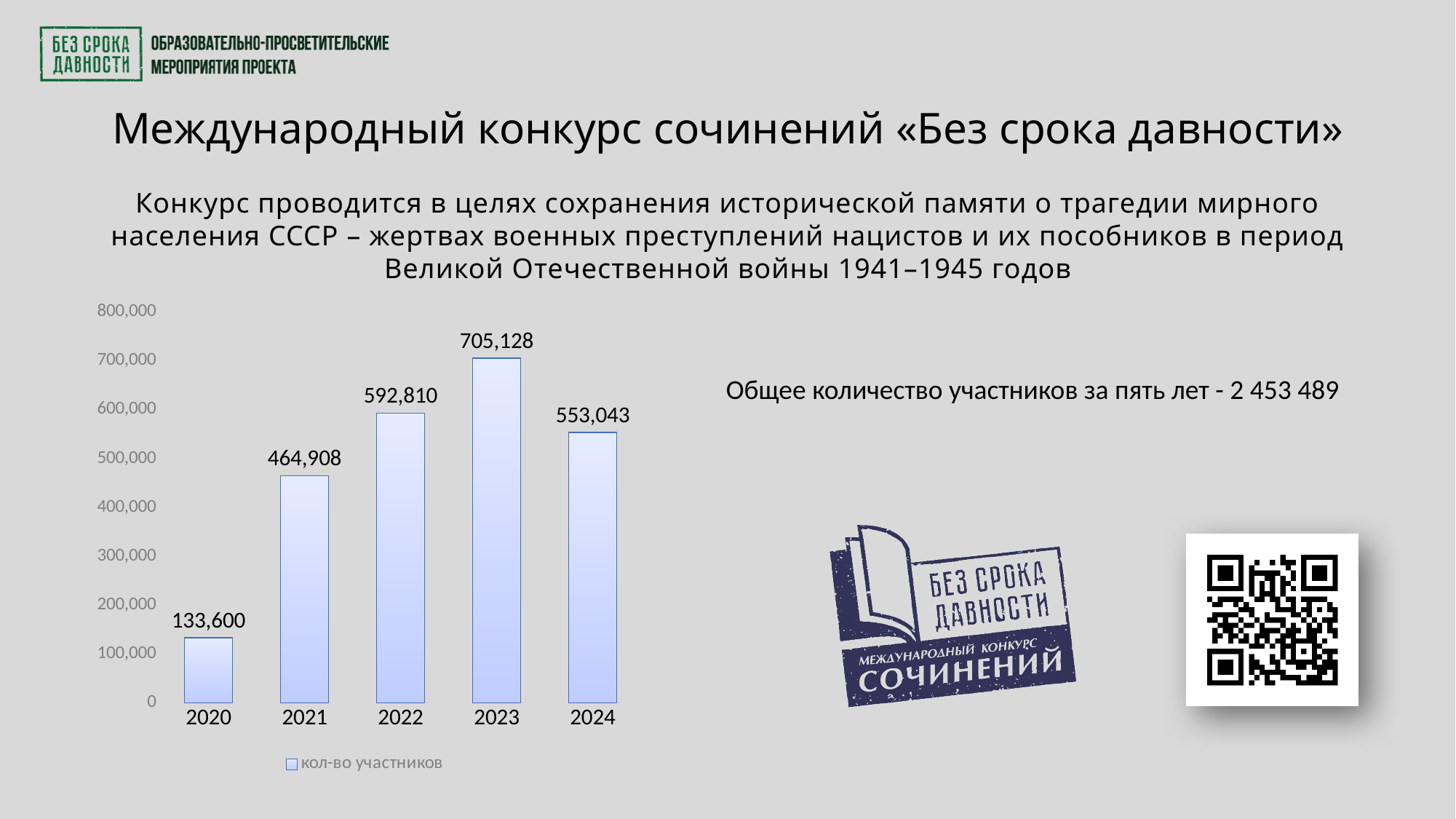
Which year has the lowest number of participants? 2020 What is the number of participants shown for 2024? 553,043 Which year has the highest number of participants? 2023 What type of chart is shown on the slide? bar chart What is the difference between the 2023 and 2024 values? 152,085 What is the number of participants shown for 2020? 133,600 How many series does the chart legend list? 1 Which year has more participants, 2022 or 2024? 2022 What is the number of participants shown for 2023? 705,128 Is the value for 2021 greater or less than 500,000? less How many years are shown on the x axis of the chart? 5 What is the difference between the 2021 and 2020 values? 331,308